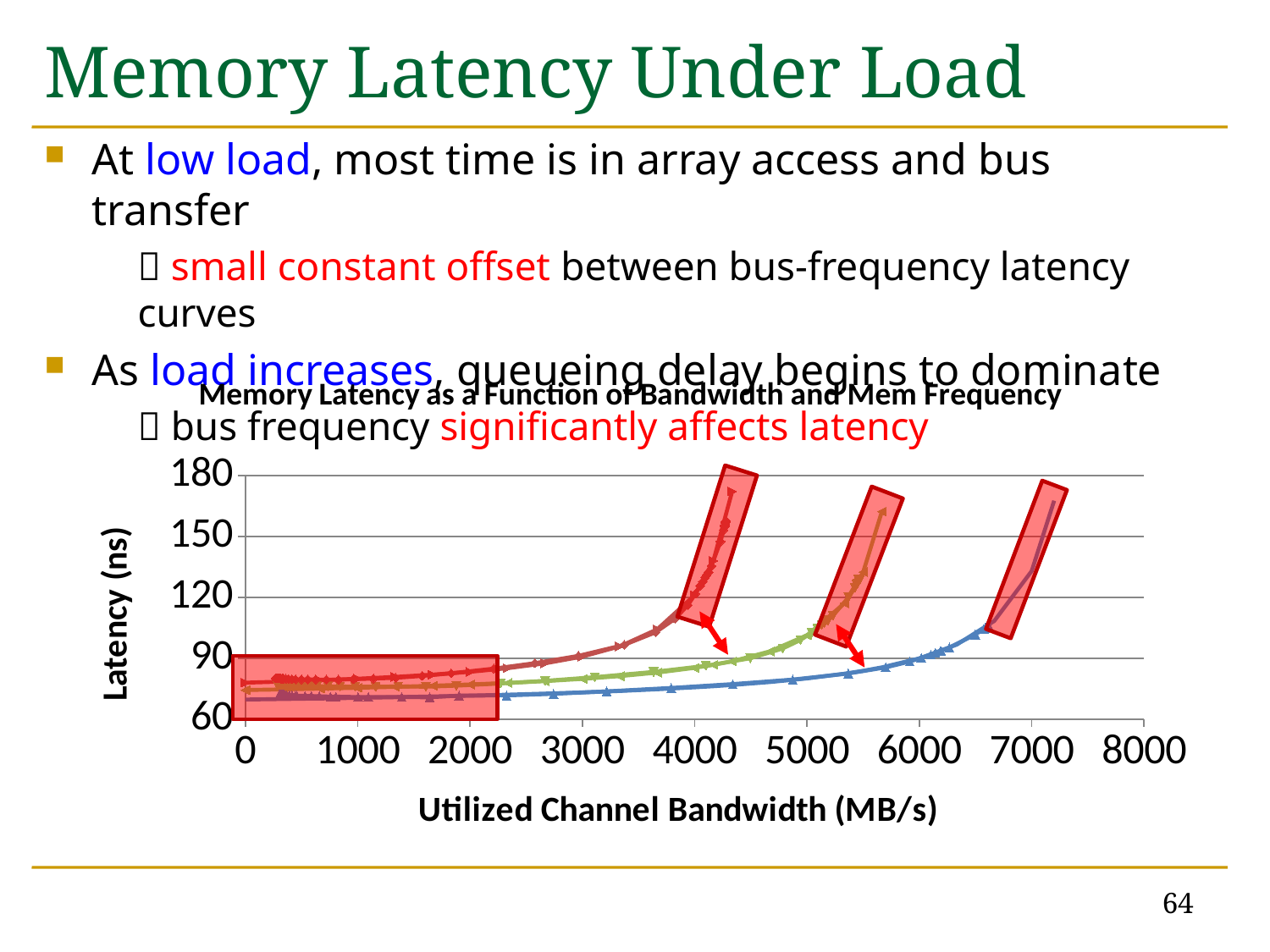
Do the latency curves rise or fall as utilized channel bandwidth increases? rise What is the label of the x axis of the chart? Utilized Channel Bandwidth (MB/s) Which curve extends to the highest utilized channel bandwidth before its latency shoots up? the blue curve What is the title of the chart? Memory Latency as a Function of Bandwidth and Mem Frequency What kind of chart is shown on the slide? line chart Is the latency of the red curve at 4000 MB/s greater or less than 90 ns? greater At 3000 MB/s, which curve has the higher latency, the red curve or the blue curve? the red curve Which curve has the lowest latency at low bandwidth (near 0 MB/s)? the blue curve Is the latency of the blue curve at 2000 MB/s greater or less than 90 ns? less Is the latency of the green curve at 5000 MB/s greater or less than 120 ns? less